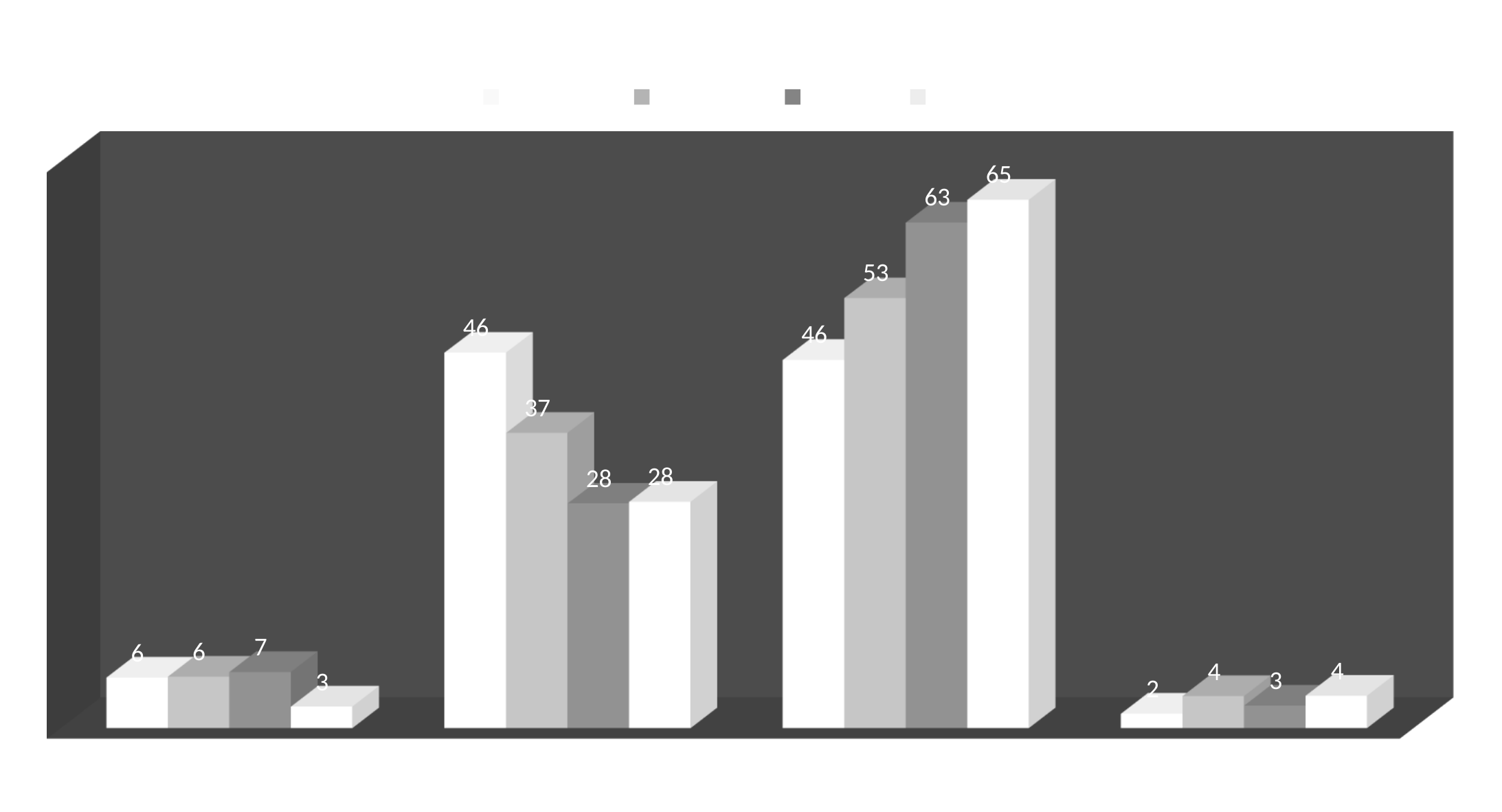
Within the third group from the left, do the bar values rise or fall from left to right? rise In the second group from the left, what is the difference between the leftmost bar (46) and the rightmost bar (28)? 18 How many series does the legend show? 4 What is the highest value labelled on the chart? 65 Which is larger: the leftmost bar of the second group or the second bar of the third group? the second bar of the third group What is the value of the rightmost bar in the third group from the left? 65 What kind of chart is shown on the slide? bar chart How many groups of bars are plotted along the x axis? 4 In the third group from the left, what is the difference between the rightmost bar (65) and the leftmost bar (46)? 19 What is the value of the tallest bar in the second group from the left? 46 What is the lowest value labelled on the chart? 2 What is the value of the leftmost bar in the fourth group from the left? 2